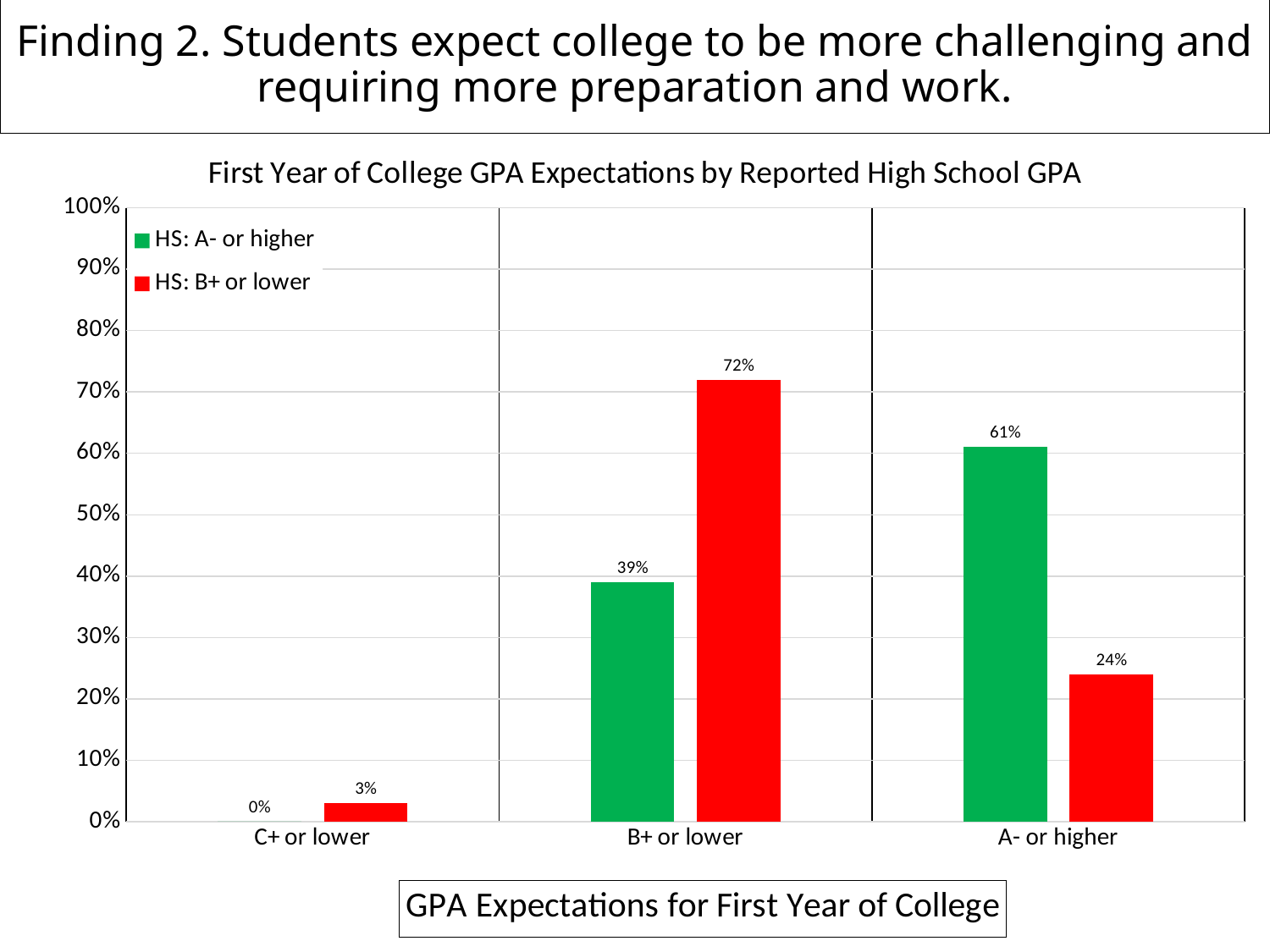
What is the value for HS: A- or higher in the C+ or lower category? 0% What is the value for HS: A- or higher in the B+ or lower category? 39% What is the title of the chart? First Year of College GPA Expectations by Reported High School GPA Which category has the highest value for the HS: B+ or lower series? B+ or lower What is the value for HS: B+ or lower in the A- or higher category? 24% What is the value for HS: B+ or lower in the C+ or lower category? 3% Which category has the lowest value for the HS: A- or higher series? C+ or lower In the A- or higher category, which series has the larger value, HS: A- or higher or HS: B+ or lower? HS: A- or higher How many series does the legend list? 2 What kind of chart is shown on the slide? Bar chart What is the difference between the HS: B+ or lower and HS: A- or higher values in the B+ or lower category? 33% How many categories are shown on the x axis? 3